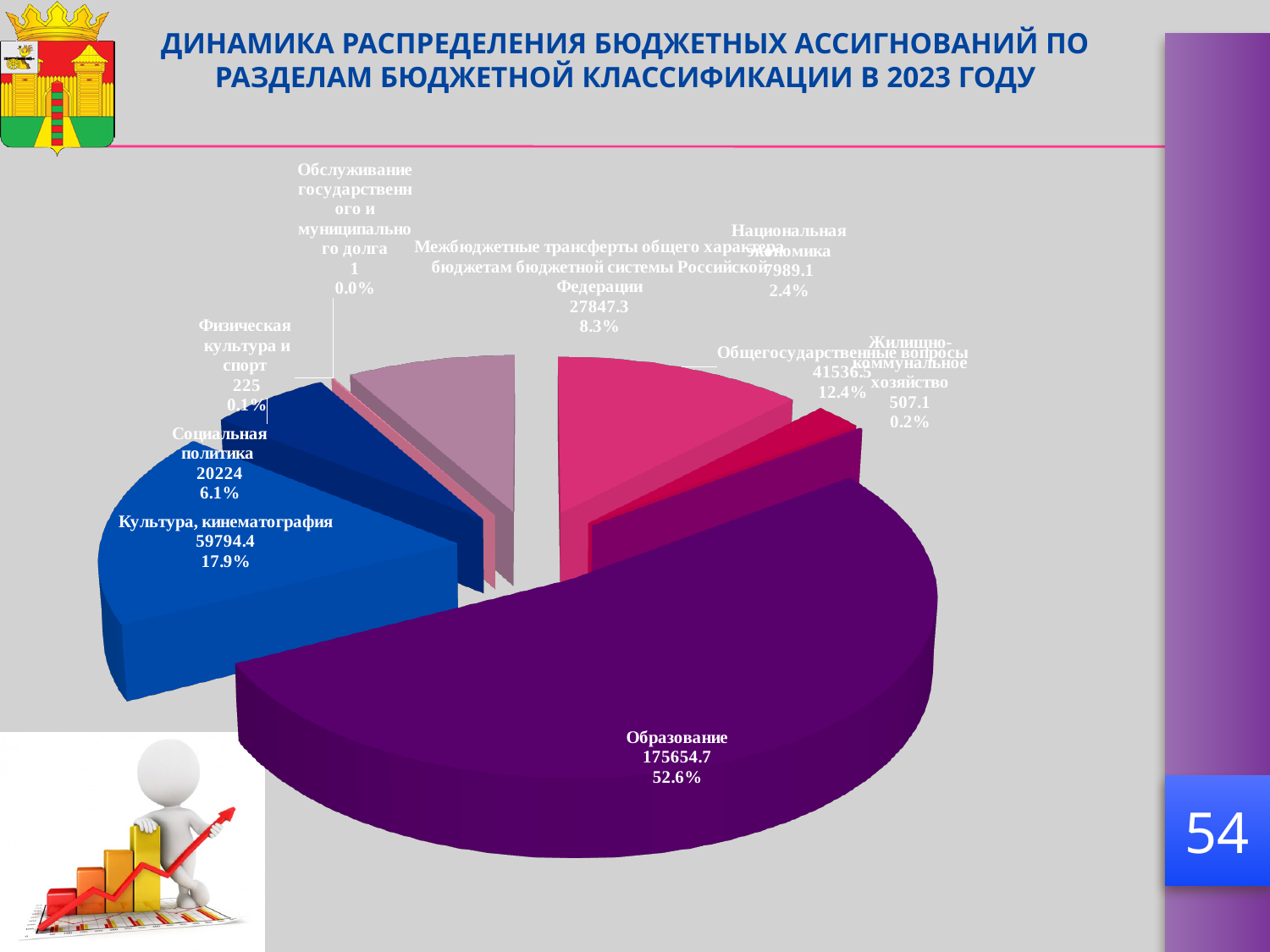
What is the value for Общегосударственные вопросы? 41536.5 What share of the pie does Образование represent? 52.6% How many categories are shown in the pie chart? 9 Which category has the largest slice of the pie? Образование What is the value for Образование? 175654.7 Which is larger, the value for Общегосударственные вопросы or the value for Социальная политика? Общегосударственные вопросы What is the difference between the values for Образование and Культура, кинематография? 115860.3 What is the value for Культура, кинематография? 59794.4 What is the value for Социальная политика? 20224 What share of the pie does Культура, кинематография represent? 17.9% Which category has the smallest value? Обслуживание государственного и муниципального долга What kind of chart is shown on the slide? Pie chart